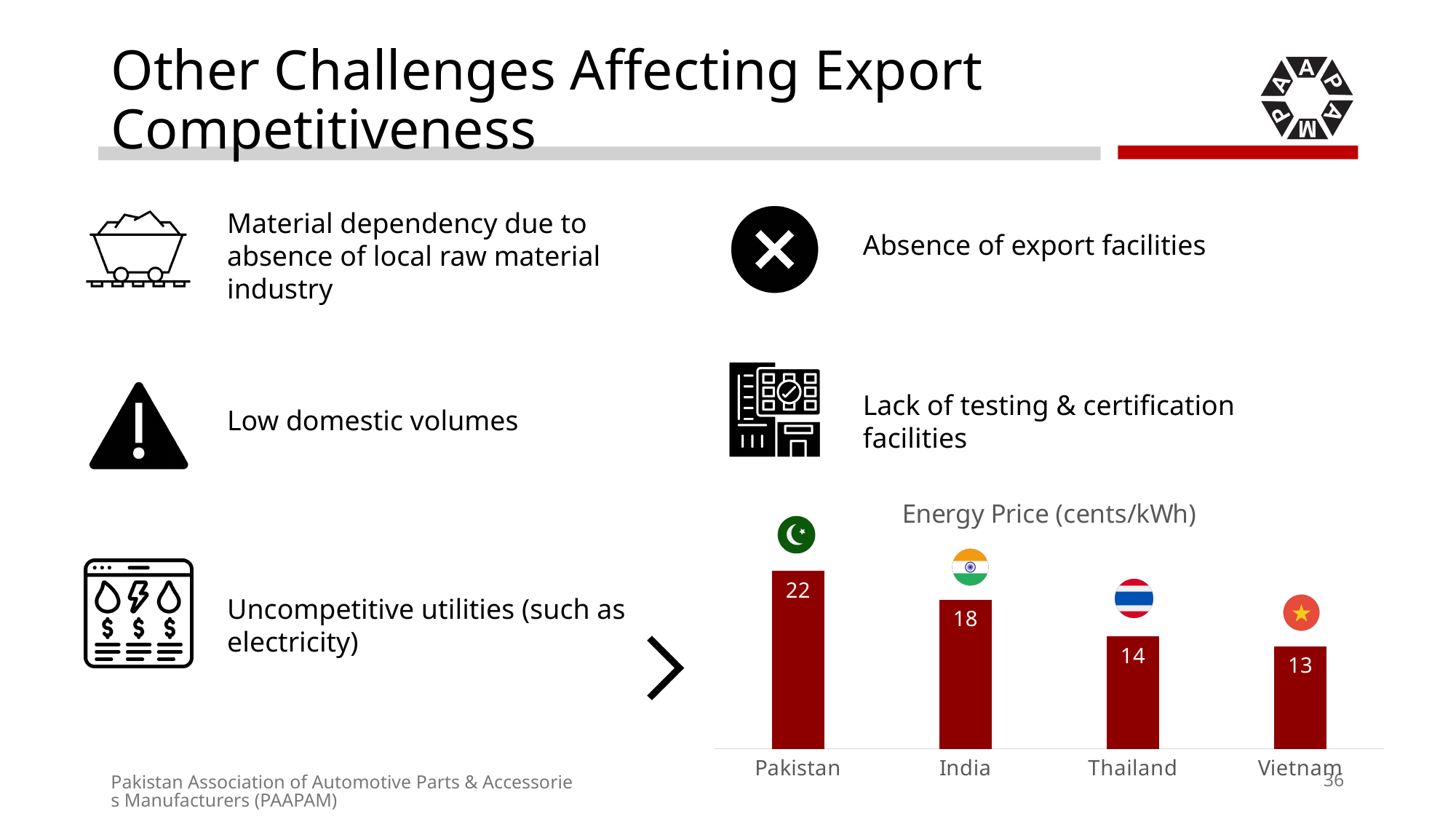
What is the energy price for Pakistan in the chart? 22 What type of chart is used to show energy prices? Bar chart What is the energy price for India in the chart? 18 What is the title of the chart on the slide? Energy Price (cents/kWh) How many countries are shown in the energy price chart? 4 Which country has the lowest energy price in the chart? Vietnam What is the difference in energy price between India and Thailand? 4 Which has a higher energy price, India or Thailand? India What is the energy price for Vietnam in the chart? 13 What is the energy price for Thailand in the chart? 14 Which country has the highest energy price in the chart? Pakistan What is the difference in energy price between Pakistan and Vietnam? 9